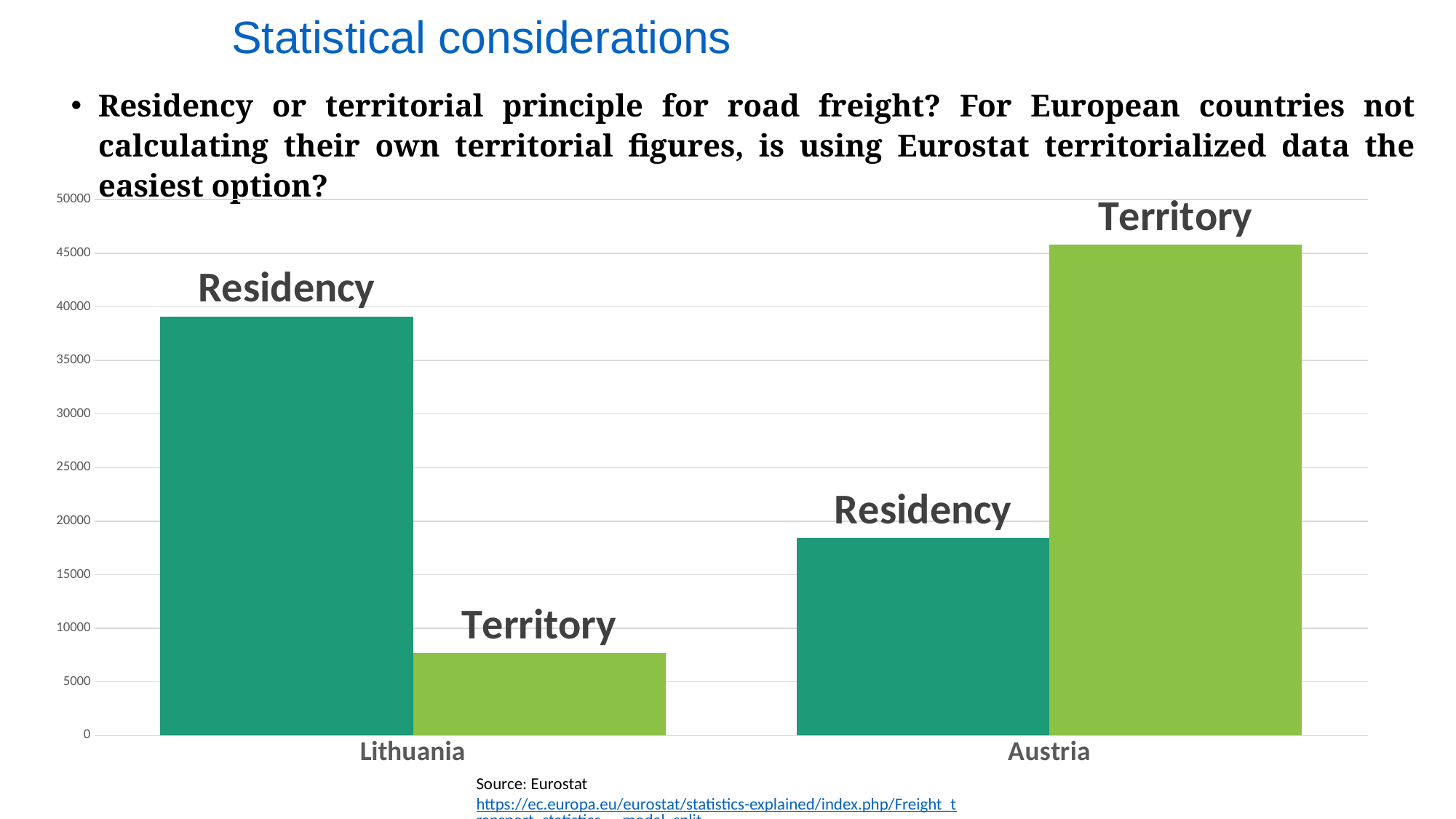
How many countries are shown on the x axis of the chart? 2 Which country has the tallest bar in the chart? Austria Is the Residency value for Lithuania greater or less than 35000? greater For Lithuania, which is larger: the Residency value or the Territory value? Residency What is the highest value shown on the chart's vertical axis? 50000 Is the Residency value for Austria greater or less than 20000? less What is the source of the data cited below the chart? Eurostat Is the Territory value for Austria greater or less than 45000? greater For Austria, which is larger: the Residency value or the Territory value? Territory Which bar is the lowest in the chart? Lithuania Territory What kind of chart is shown on the slide? bar chart